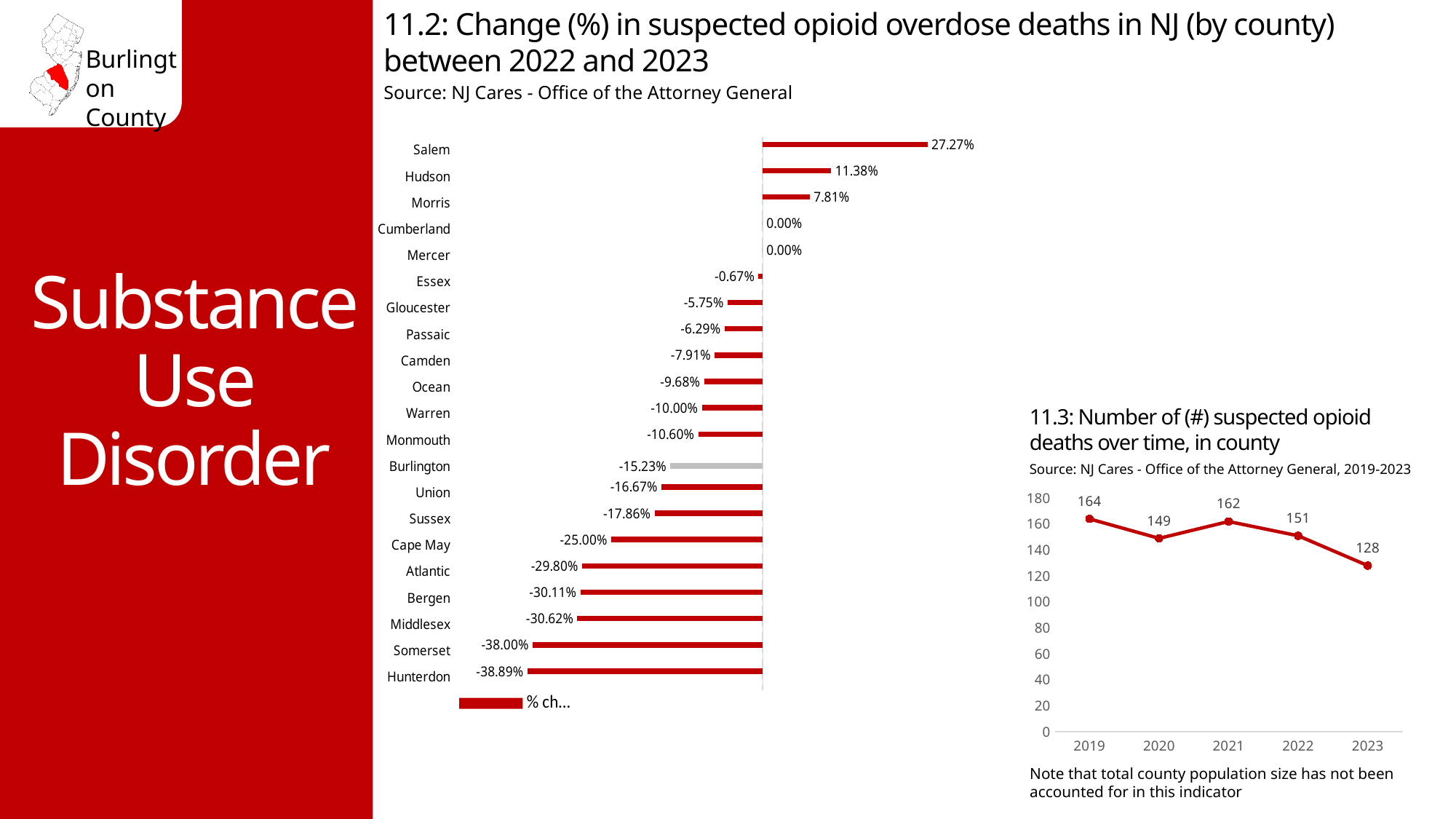
In the chart '11.2: Change (%) in suspected opioid overdose deaths in NJ (by county) between 2022 and 2023', what is the value for Burlington? -15.23% In the chart '11.2: Change (%) in suspected opioid overdose deaths in NJ (by county) between 2022 and 2023', which county has the lowest value? Hunterdon In the chart '11.2: Change (%) in suspected opioid overdose deaths in NJ (by county) between 2022 and 2023', what is the value for Hudson? 11.38% In the chart '11.3: Number of (#) suspected opioid deaths over time, in county', what is the difference between the 2019 value and the 2023 value? 36 In the chart '11.2: Change (%) in suspected opioid overdose deaths in NJ (by county) between 2022 and 2023', which county has the highest value? Salem What kind of chart is '11.3: Number of (#) suspected opioid deaths over time, in county'? Line chart In the chart '11.2: Change (%) in suspected opioid overdose deaths in NJ (by county) between 2022 and 2023', which is larger, the value for Cape May or the value for Atlantic? Cape May What kind of chart is '11.2: Change (%) in suspected opioid overdose deaths in NJ (by county) between 2022 and 2023'? Bar chart In the chart '11.2: Change (%) in suspected opioid overdose deaths in NJ (by county) between 2022 and 2023', how many counties are shown? 21 In the chart '11.3: Number of (#) suspected opioid deaths over time, in county', what is the value for 2021? 162 In the chart '11.3: Number of (#) suspected opioid deaths over time, in county', how many data points are plotted? 5 In the chart '11.3: Number of (#) suspected opioid deaths over time, in county', which year has the lowest value? 2023